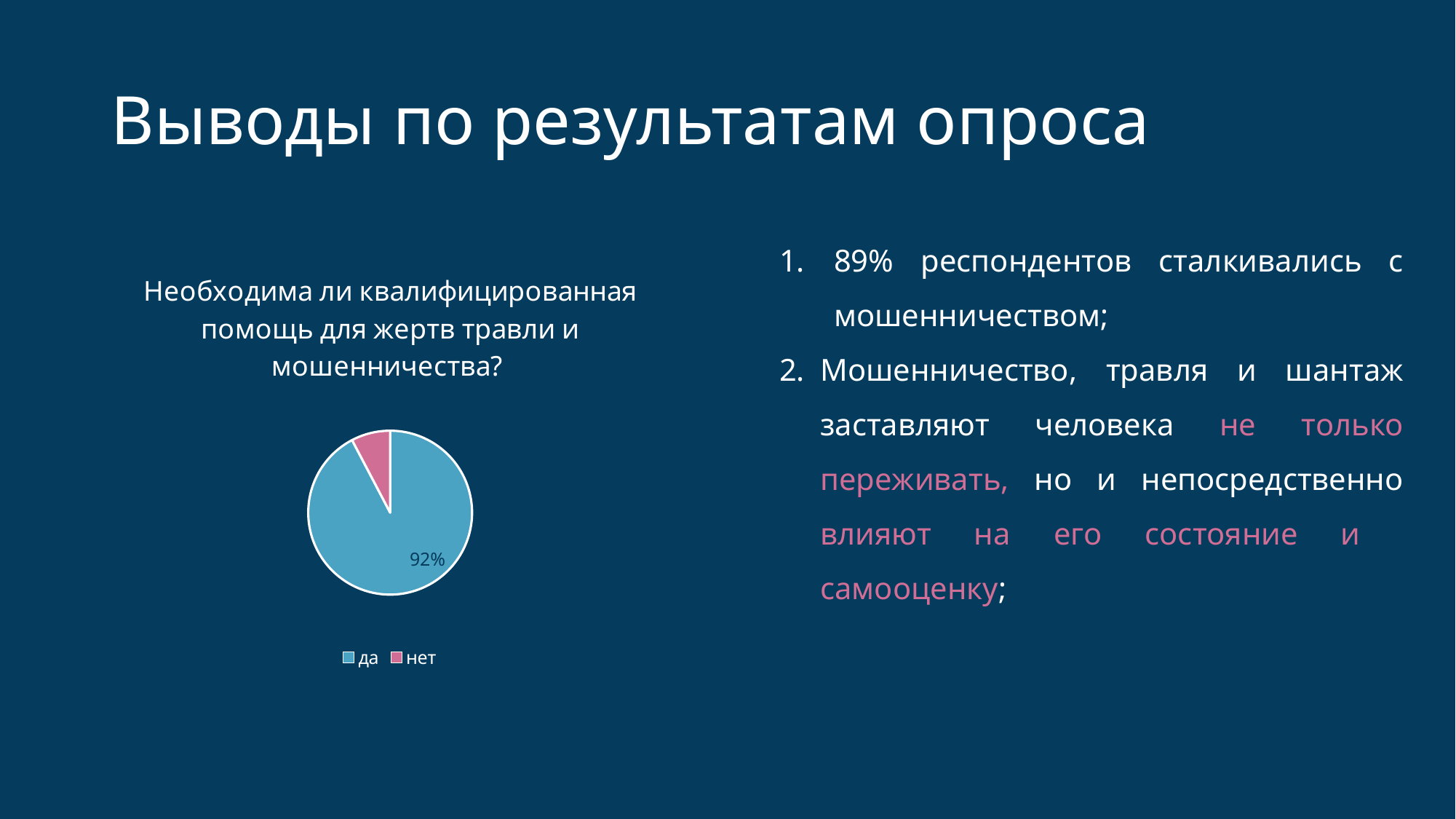
Which slice is larger in the pie chart, "да" or "нет"? да What value is labelled on the "да" slice of the pie chart? 92% Which category has the largest slice in the pie chart? да What share of the pie does the "да" slice represent? 92% What is the title of the pie chart? Необходима ли квалифицированная помощь для жертв травли и мошенничества? What colour is the "нет" slice in the pie chart? pink How many categories (slices) does the pie chart have? 2 What kind of chart is shown on the slide? pie chart Which category has the smallest slice in the pie chart? нет How many entries does the legend of the pie chart list? 2